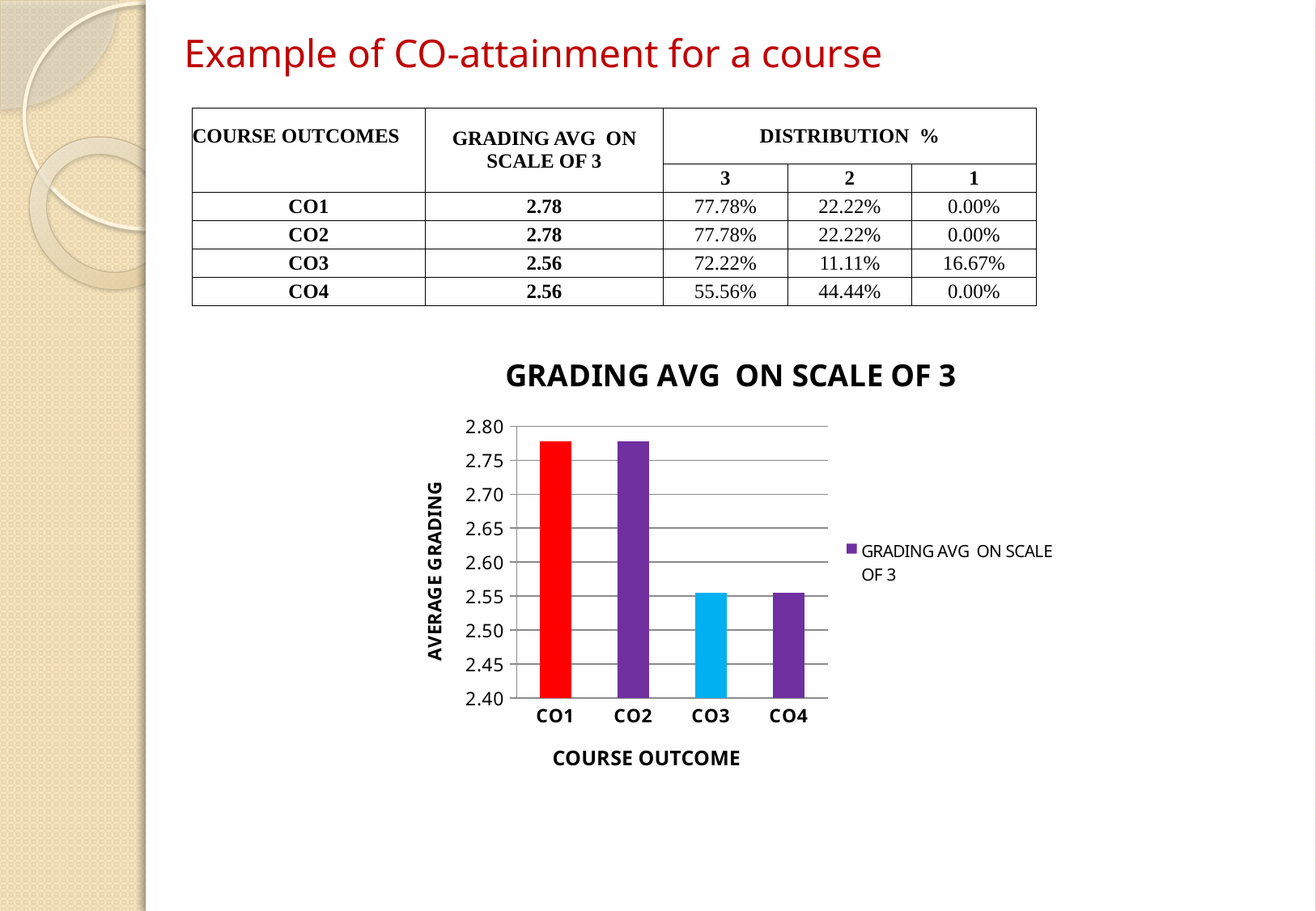
What kind of chart is shown on the slide? bar chart Do the bar values rise or fall from CO1 to CO4? fall What is the difference between the grading averages of CO1 and CO3? 0.22 What is the grading average on scale of 3 for CO3? 2.56 How many course outcomes are plotted on the x axis of the chart? 4 How many series does the chart legend list? 1 Is the value for CO4 greater or less than 2.65? less Is the value for CO3 greater or less than 2.60? less Is the value for CO1 greater or less than 2.70? greater What is the title of the chart? GRADING AVG ON SCALE OF 3 What is the grading average on scale of 3 for CO1? 2.78 Which has a higher grading average, CO2 or CO4? CO2